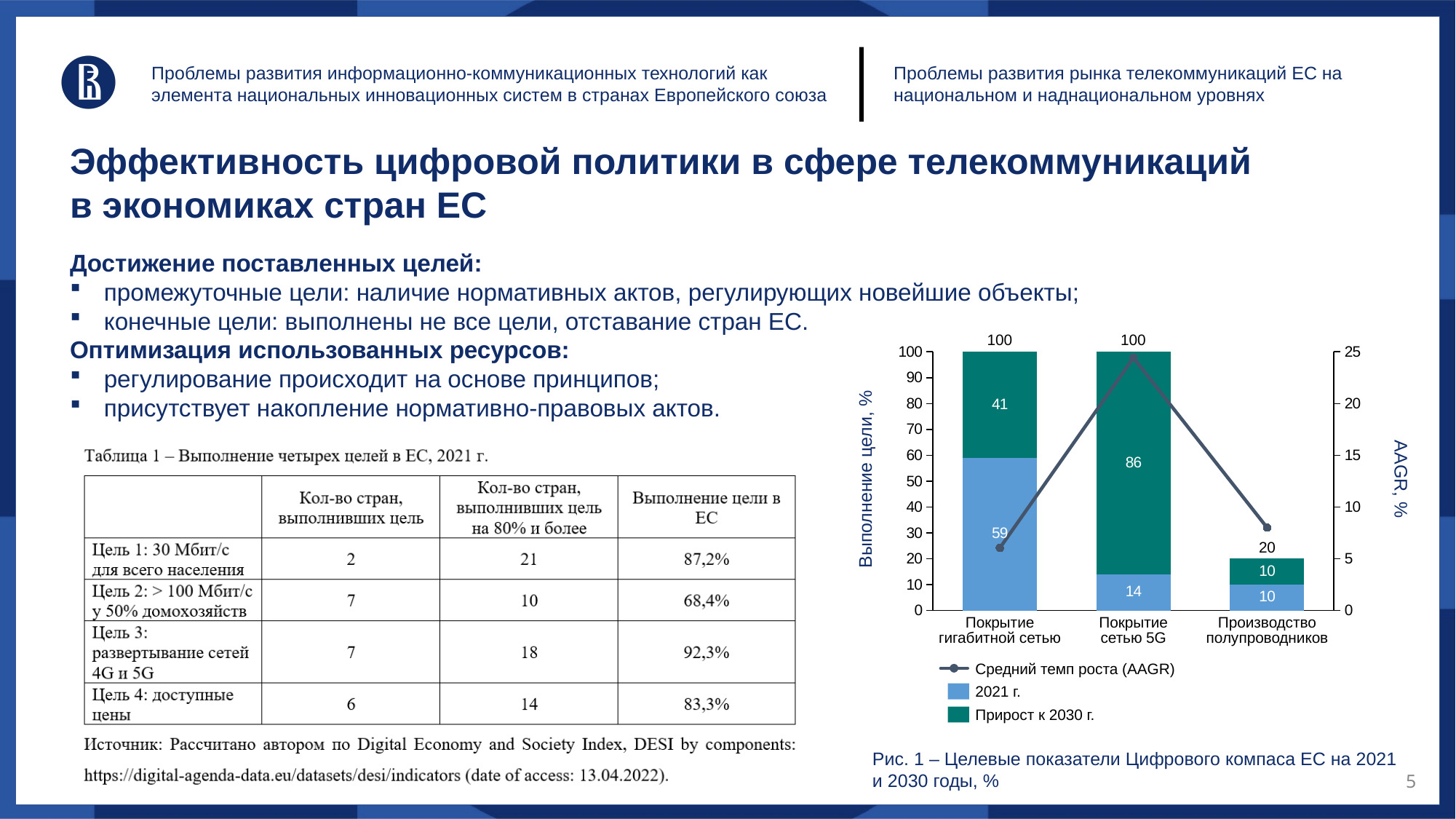
Is the Средний темп роста (AAGR) value for Покрытие сетью 5G greater or less than 20? greater What is the difference between the 2021 г. values for Покрытие гигабитной сетью and Покрытие сетью 5G? 45 Which category has the highest Прирост к 2030 г. value? Покрытие сетью 5G What is the 2021 г. value for Покрытие гигабитной сетью? 59 How many categories are shown on the x axis of the chart? 3 What is the Прирост к 2030 г. value for Покрытие сетью 5G? 86 How many series does the chart legend list? 3 What is the total of the stacked bar for Производство полупроводников? 20 What is the 2021 г. value for Производство полупроводников? 10 Which category has the lowest 2021 г. value? Производство полупроводников Is the Средний темп роста (AAGR) value for Покрытие гигабитной сетью greater or less than 10? less Which is larger: the 2021 г. value for Покрытие гигабитной сетью or the Прирост к 2030 г. value for Покрытие гигабитной сетью? 2021 г.